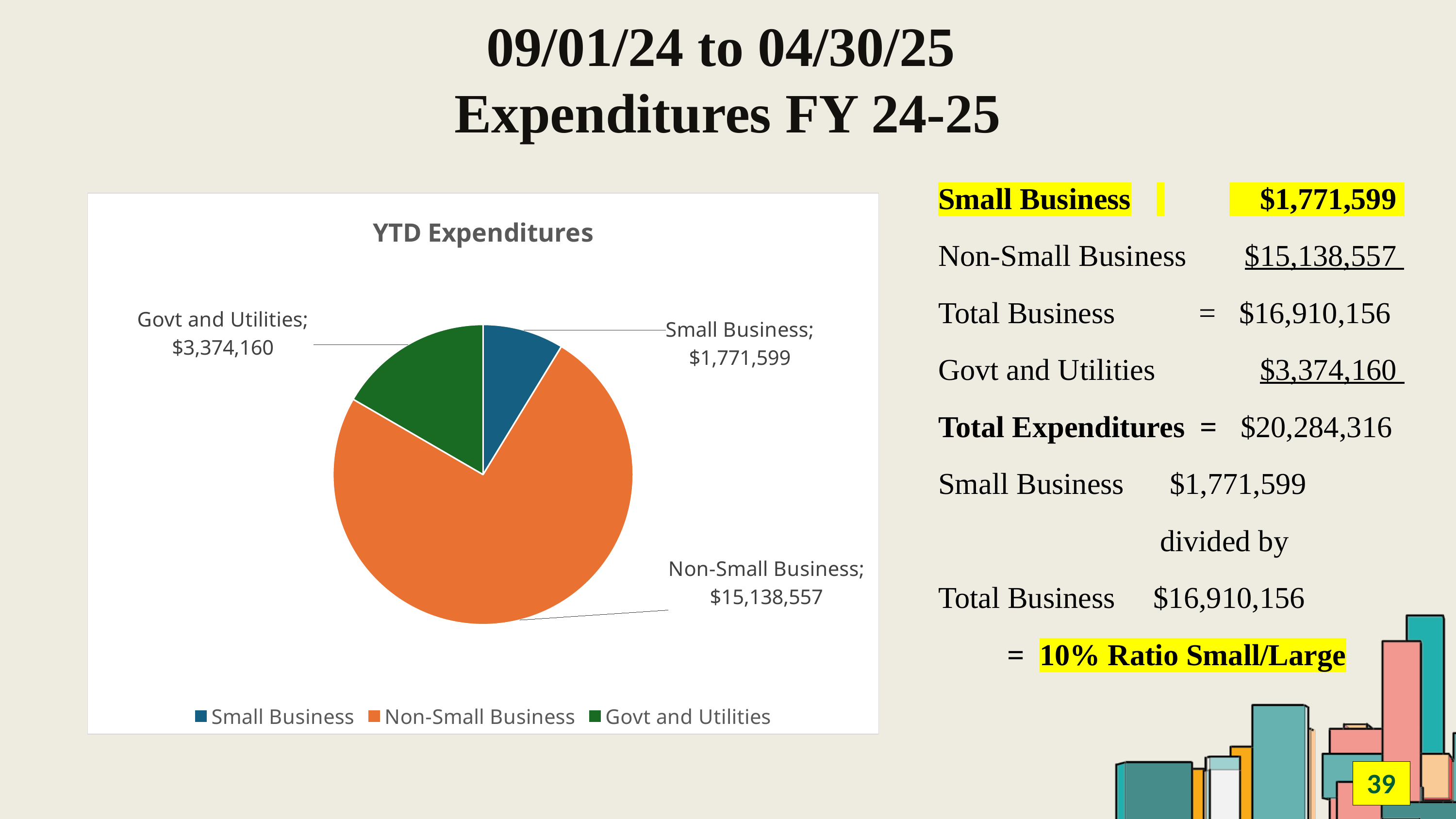
What is the value for Govt and Utilities in the YTD Expenditures chart? $3,374,160 What is the title of the chart? YTD Expenditures What is the value for Small Business in the YTD Expenditures chart? $1,771,599 Which category has the largest slice in the YTD Expenditures chart? Non-Small Business Which category has the smallest slice in the YTD Expenditures chart? Small Business What type of chart is shown on the slide? Pie chart How many categories are shown in the YTD Expenditures pie chart? 3 How many entries does the legend of the YTD Expenditures chart list? 3 What is the total of all three slices in the YTD Expenditures chart? $20,284,316 What is the difference between the Non-Small Business and Govt and Utilities values in the YTD Expenditures chart? $11,764,397 What is the value for Non-Small Business in the YTD Expenditures chart? $15,138,557 Which is larger in the YTD Expenditures chart, Govt and Utilities or Small Business? Govt and Utilities